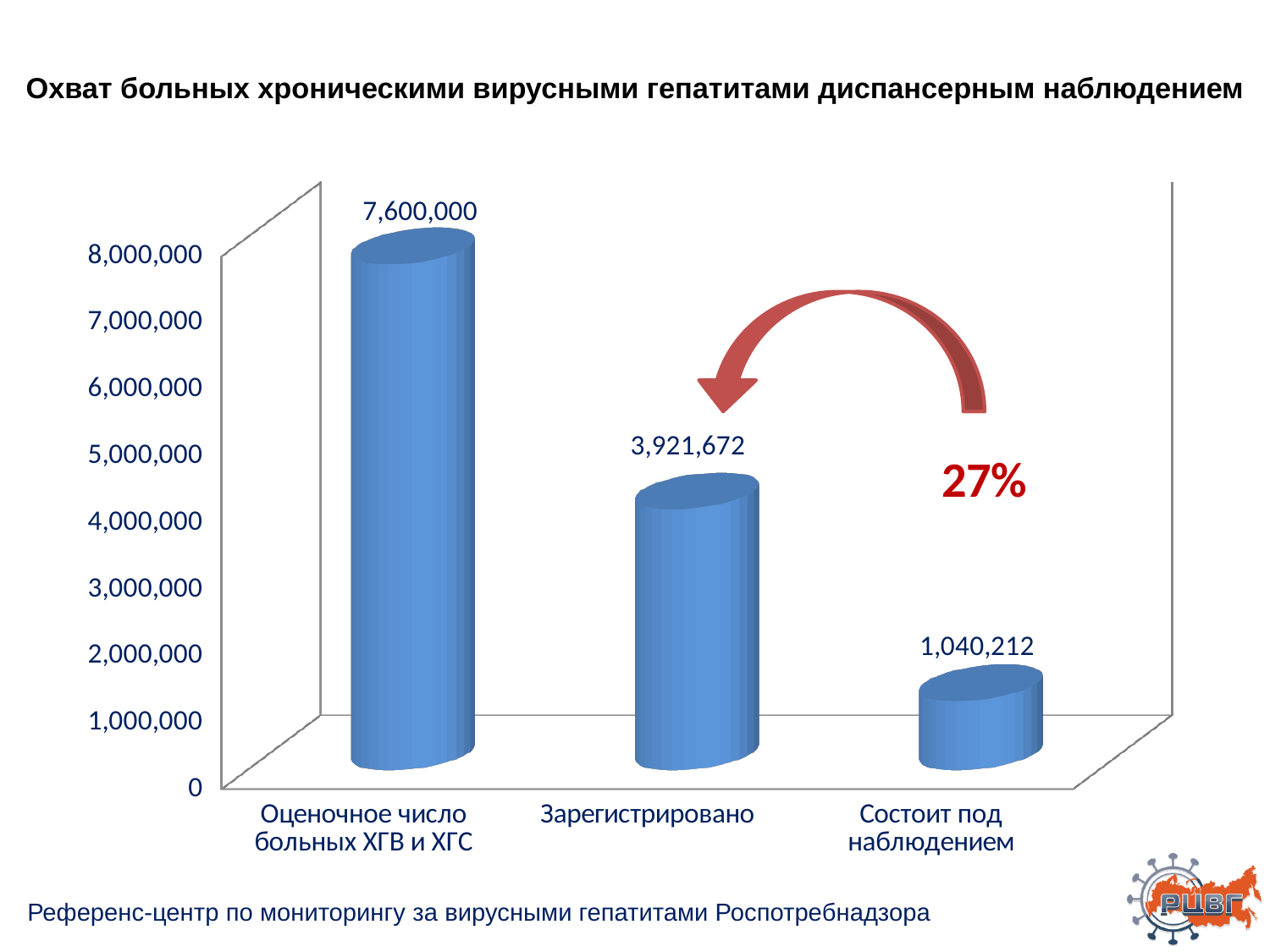
What percentage is printed in red next to the arrow on the chart? 27% What is the difference between the values for "Зарегистрировано" and "Состоит под наблюдением"? 2,881,460 Which is larger, the value for "Зарегистрировано" or the value for "Состоит под наблюдением"? Зарегистрировано Which category has the lowest value? Состоит под наблюдением What is the value for "Зарегистрировано"? 3,921,672 How many categories are shown on the x axis? 3 Is the value for "Зарегистрировано" greater or less than 3,000,000? greater Which category has the highest value? Оценочное число больных ХГВ и ХГС What is the value for "Оценочное число больных ХГВ и ХГС"? 7,600,000 What is the difference between the values for "Оценочное число больных ХГВ и ХГС" and "Зарегистрировано"? 3,678,328 What kind of chart is shown on the slide? bar chart What is the value for "Состоит под наблюдением"? 1,040,212